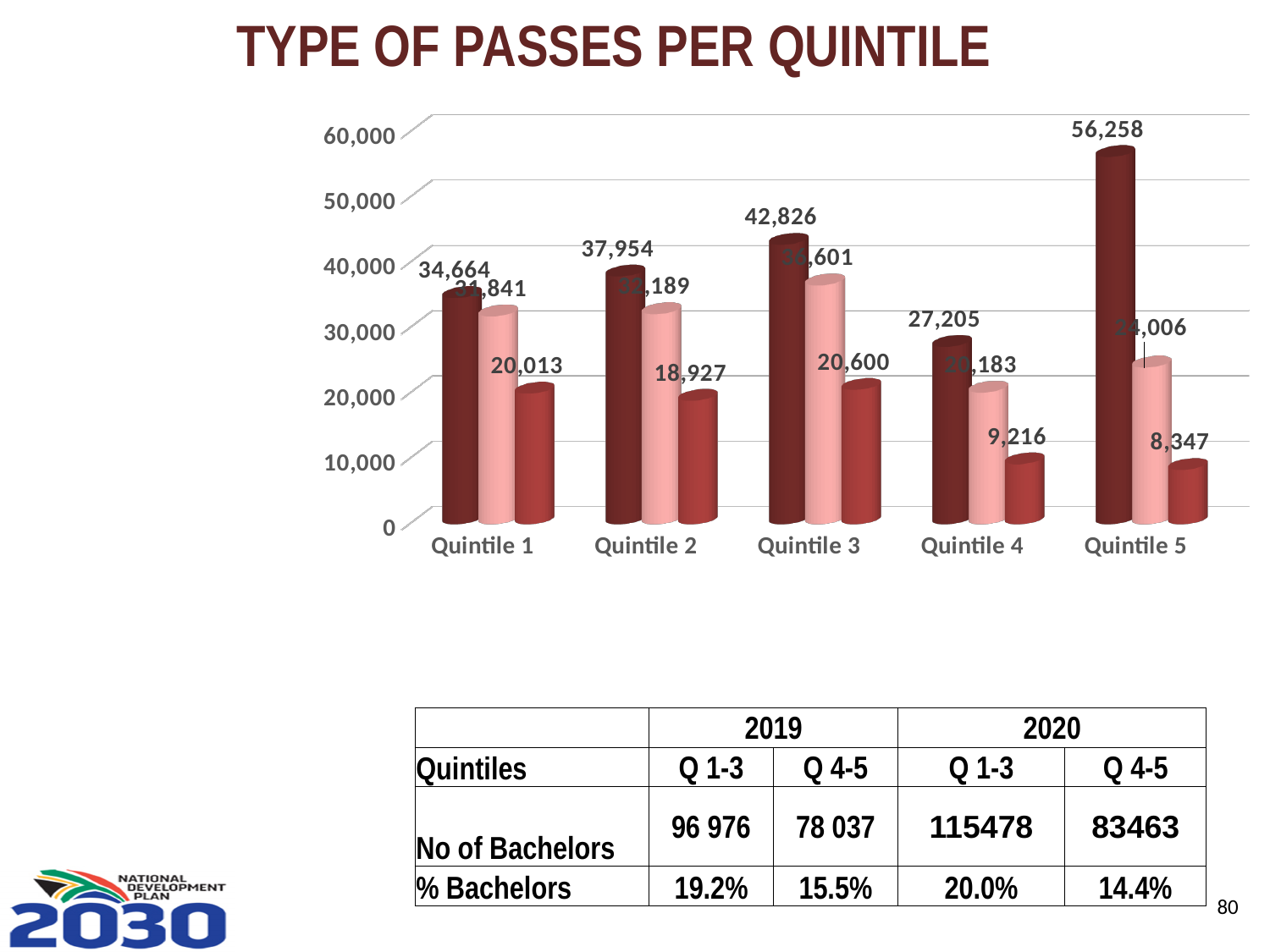
What is the title of the chart? TYPE OF PASSES PER QUINTILE How many quintile categories are shown on the x axis of the chart? 5 What type of chart is shown on the slide? bar chart What is the value of the shortest (third) bar for Quintile 1? 20,013 Is the dark red (first) bar for Quintile 4 greater or less than 30,000? less What is the value of the shortest (third) bar for Quintile 4? 9,216 What is the difference between the dark red (first) bar values for Quintile 5 and Quintile 4? 29,053 Which quintile has the lowest value for the shortest (third) bar? Quintile 5 Which is larger: the third bar for Quintile 2 or the third bar for Quintile 3? Quintile 3 Which quintile has the highest value for the dark red (first) bar? Quintile 5 What is the value of the tallest (dark red) bar for Quintile 3? 42,826 What is the value of the tallest (dark red) bar for Quintile 5? 56,258